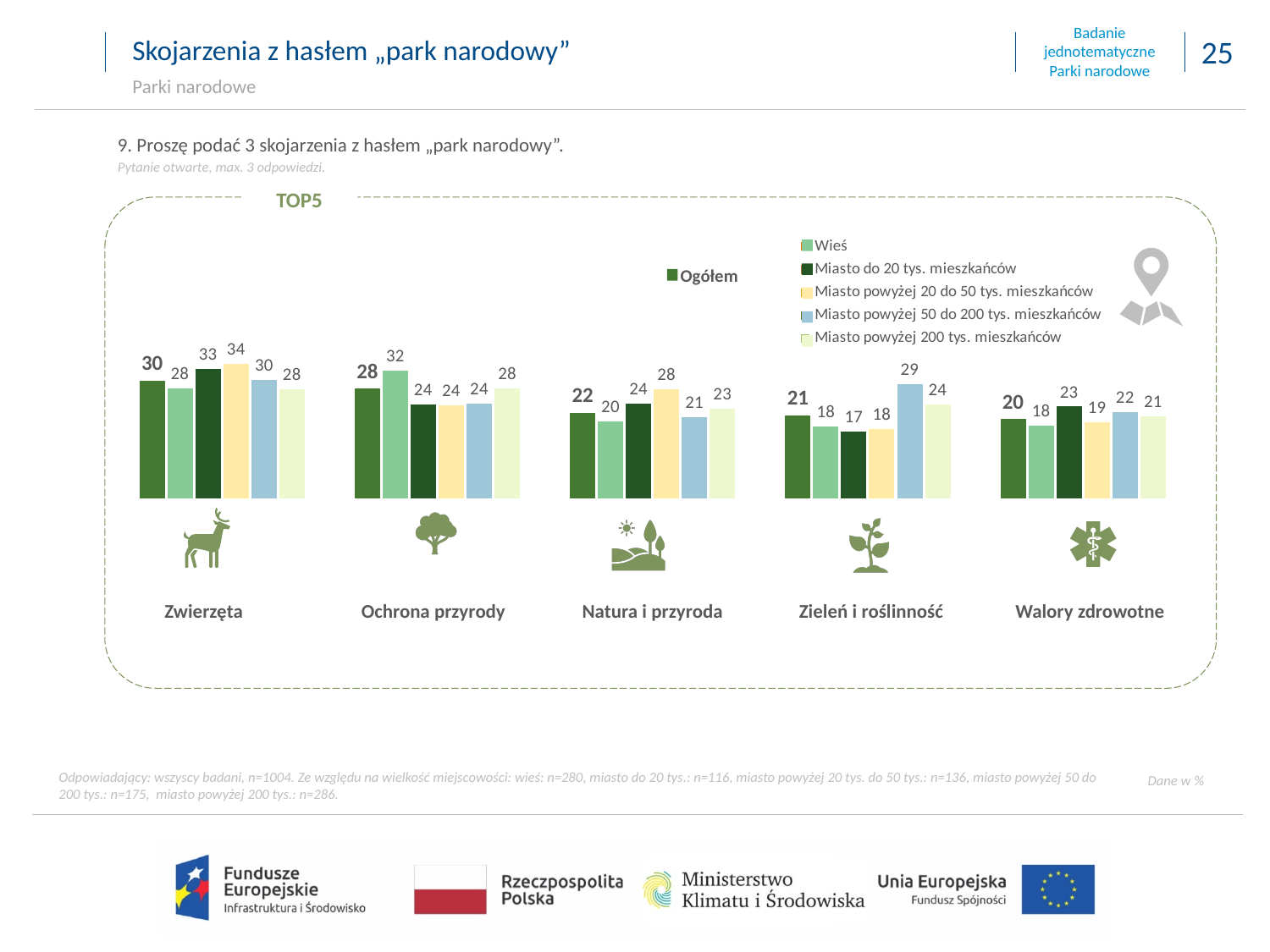
How many data series are plotted for each category? 6 What is the Ogółem value for Zwierzęta? 30 What is the value for Miasto powyżej 20 do 50 tys. mieszkańców in the Natura i przyroda category? 28 What is the value for Miasto powyżej 50 do 200 tys. mieszkańców in the Zieleń i roślinność category? 29 What is the difference between the Ogółem values for Zwierzęta and Walory zdrowotne? 10 What type of chart is shown on the slide? Bar chart Do the Ogółem values rise or fall from Zwierzęta to Walory zdrowotne? Fall In the Zieleń i roślinność category, which is larger: the value for Wieś or for Miasto powyżej 200 tys. mieszkańców? Miasto powyżej 200 tys. mieszkańców Which category has the lowest Ogółem value? Walory zdrowotne How many categories (associations) are shown in the chart? 5 Which category has the highest Ogółem value? Zwierzęta What is the value for Wieś in the Ochrona przyrody category? 32